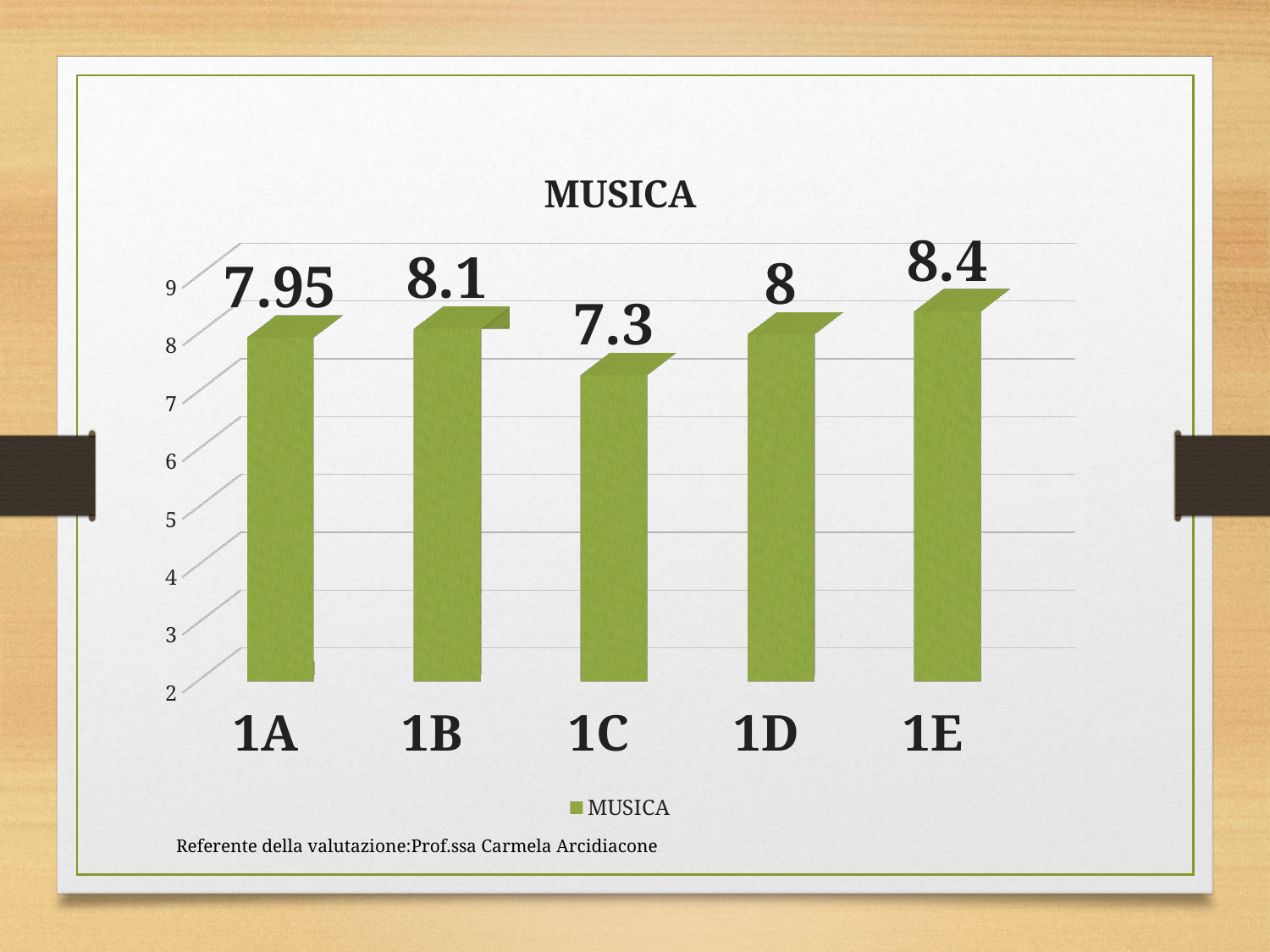
What is the value for 1E? 8.4 How many classes are shown on the x axis? 5 What is the difference between the values for 1E and 1C? 1.1 What kind of chart is this? bar chart What is the value for 1A? 7.95 Is the value for 1C greater or less than 8? less What is the title of the chart? MUSICA Which class has the highest value? 1E What is the value for 1C? 7.3 Which is larger, the value for 1B or the value for 1D? 1B What is the difference between the values for 1B and 1A? 0.15 Which class has the lowest value? 1C